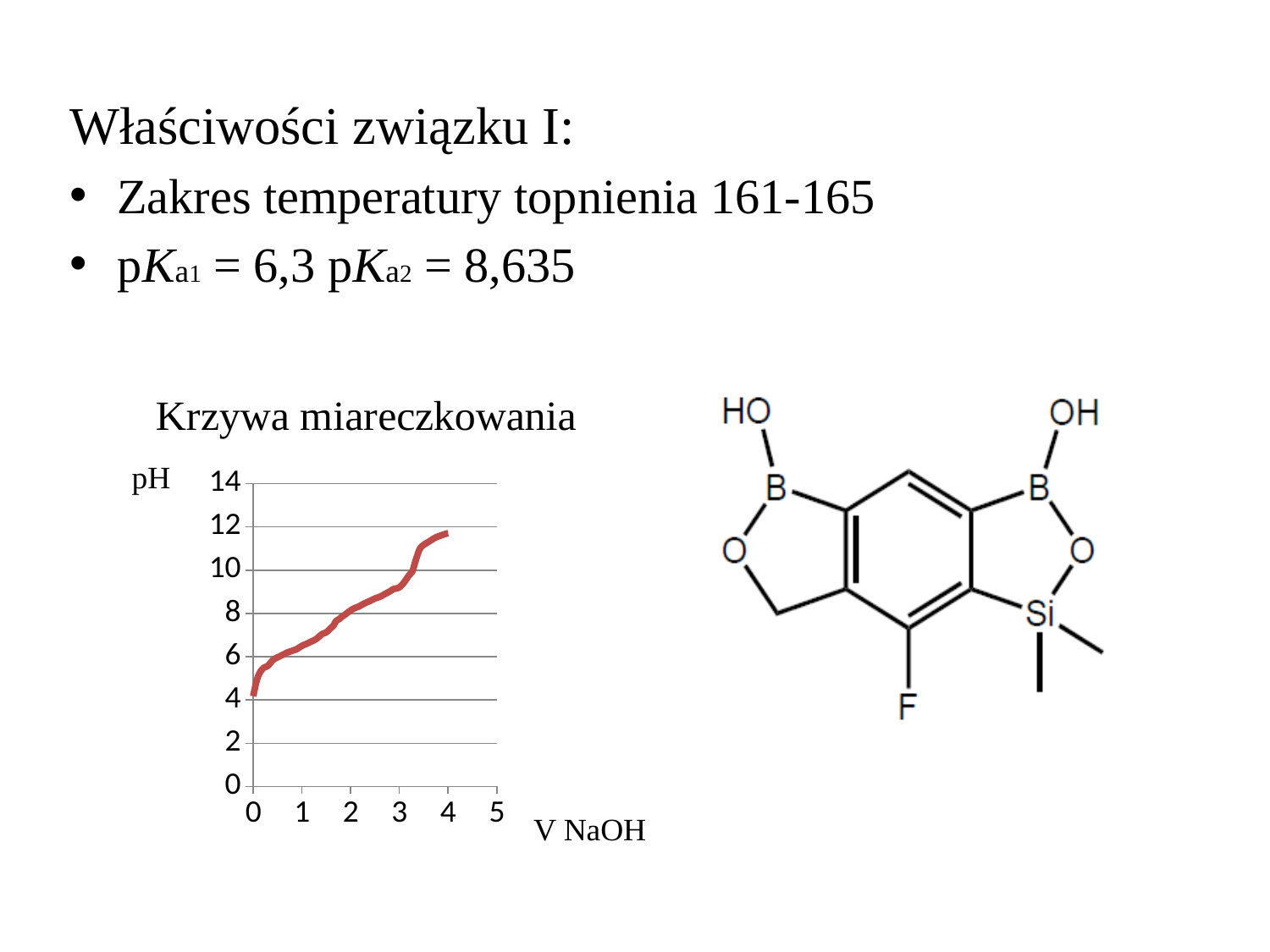
Is the pH value at V NaOH = 2 greater or less than 10? less Is the pH value at V NaOH = 2 greater or less than 6? greater Is the pH value at V NaOH = 0 greater or less than 6? less What label is shown on the vertical axis of the chart? pH What kind of chart is shown on the slide? line chart What is the highest tick value shown on the vertical (pH) axis of the chart? 14 Does the pH value rise or fall as V NaOH increases along the x axis? rise Which has the higher pH on the curve: V NaOH = 1 or V NaOH = 3? V NaOH = 3 What is the title of the chart on the slide? Krzywa miareczkowania